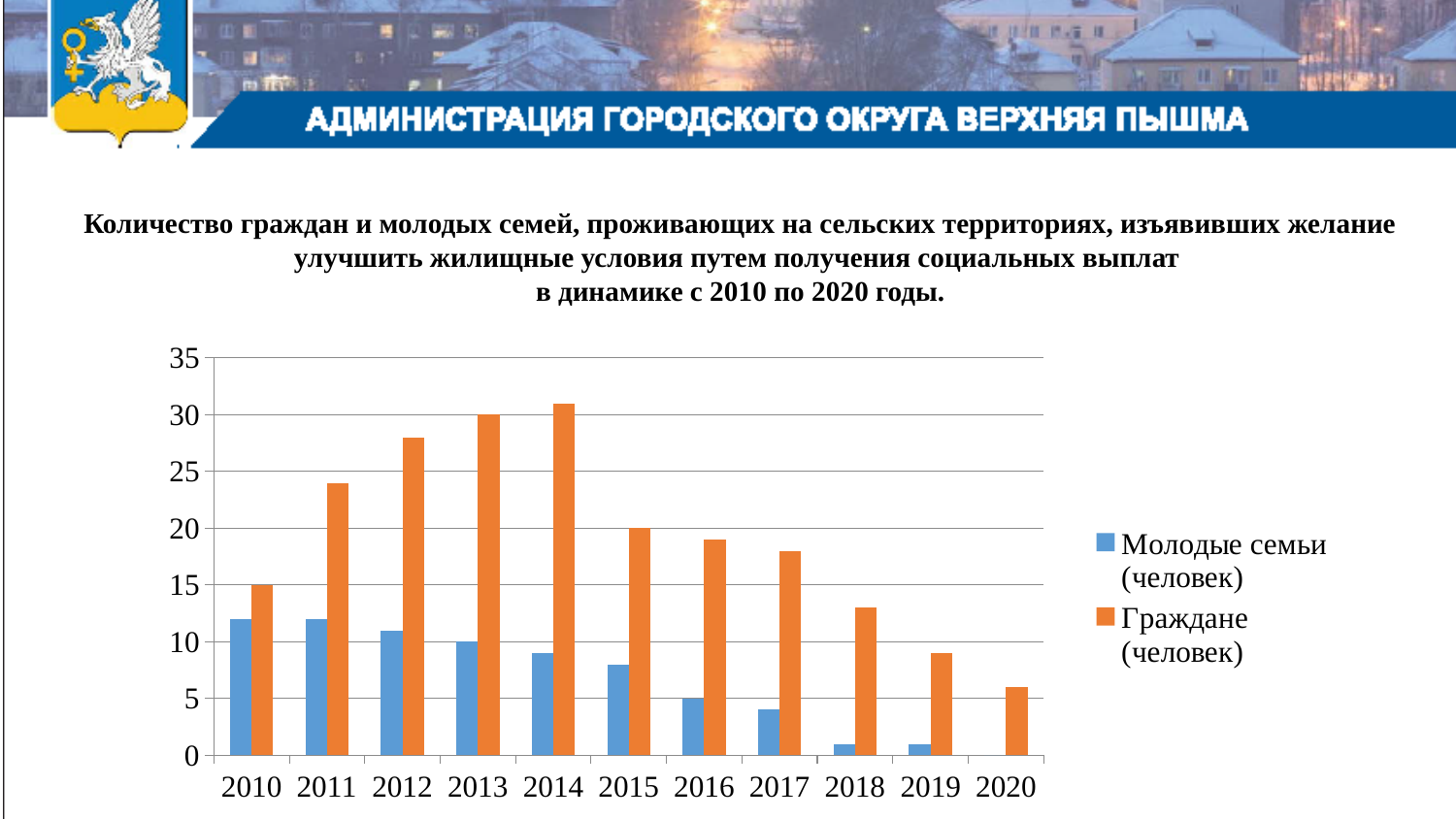
In which year is the value for Граждане (человек) lowest? 2020 What is the value for Молодые семьи (человек) in 2013? 10 What is the value for Граждане (человек) in 2010? 15 What is the value for Граждане (человек) in 2015? 20 How many years are shown on the x axis? 11 Is the value for Граждане (человек) in 2012 greater or less than 25? greater What is the value for Молодые семьи (человек) in 2016? 5 How many series does the legend list? 2 What type of chart is shown on the slide? bar chart What is the value for Граждане (человек) in 2013? 30 Do the values for Граждане (человек) rise or fall from 2014 to 2020? fall Is the value for Молодые семьи (человек) in 2015 greater or less than 10? less